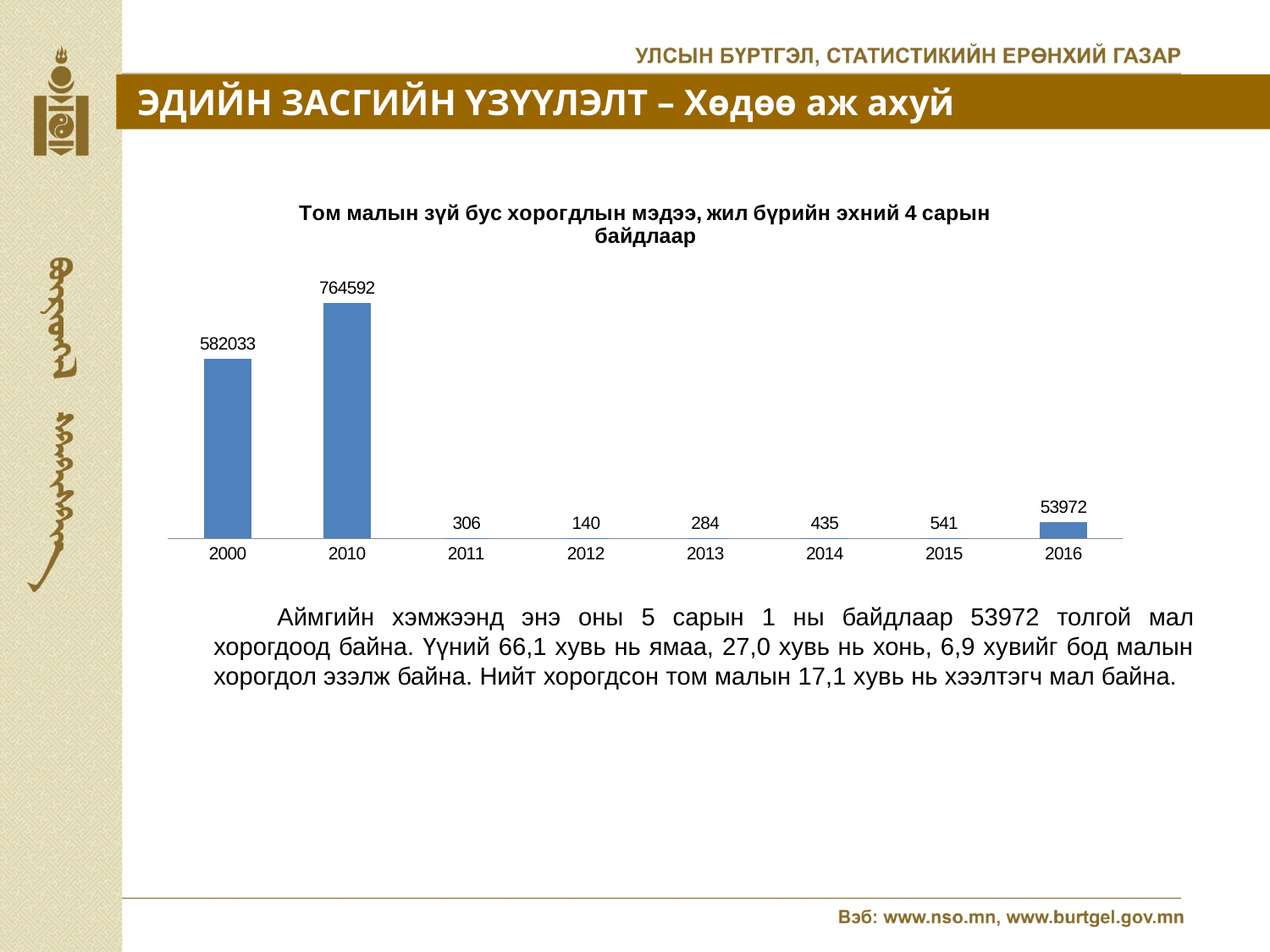
Do the values rise or fall from 2012 to 2016? Rise What is the value for 2010? 764592 What kind of chart is shown on the slide? Bar chart What is the difference between the values for 2015 and 2014? 106 Which is larger, the value for 2013 or the value for 2014? 2014 What is the value for 2012? 140 What is the value for 2016? 53972 Which year has the highest value? 2010 Which year has the lowest value? 2012 What is the difference between the values for 2010 and 2000? 182559 How many years are shown on the x axis? 8 What is the value for 2000? 582033